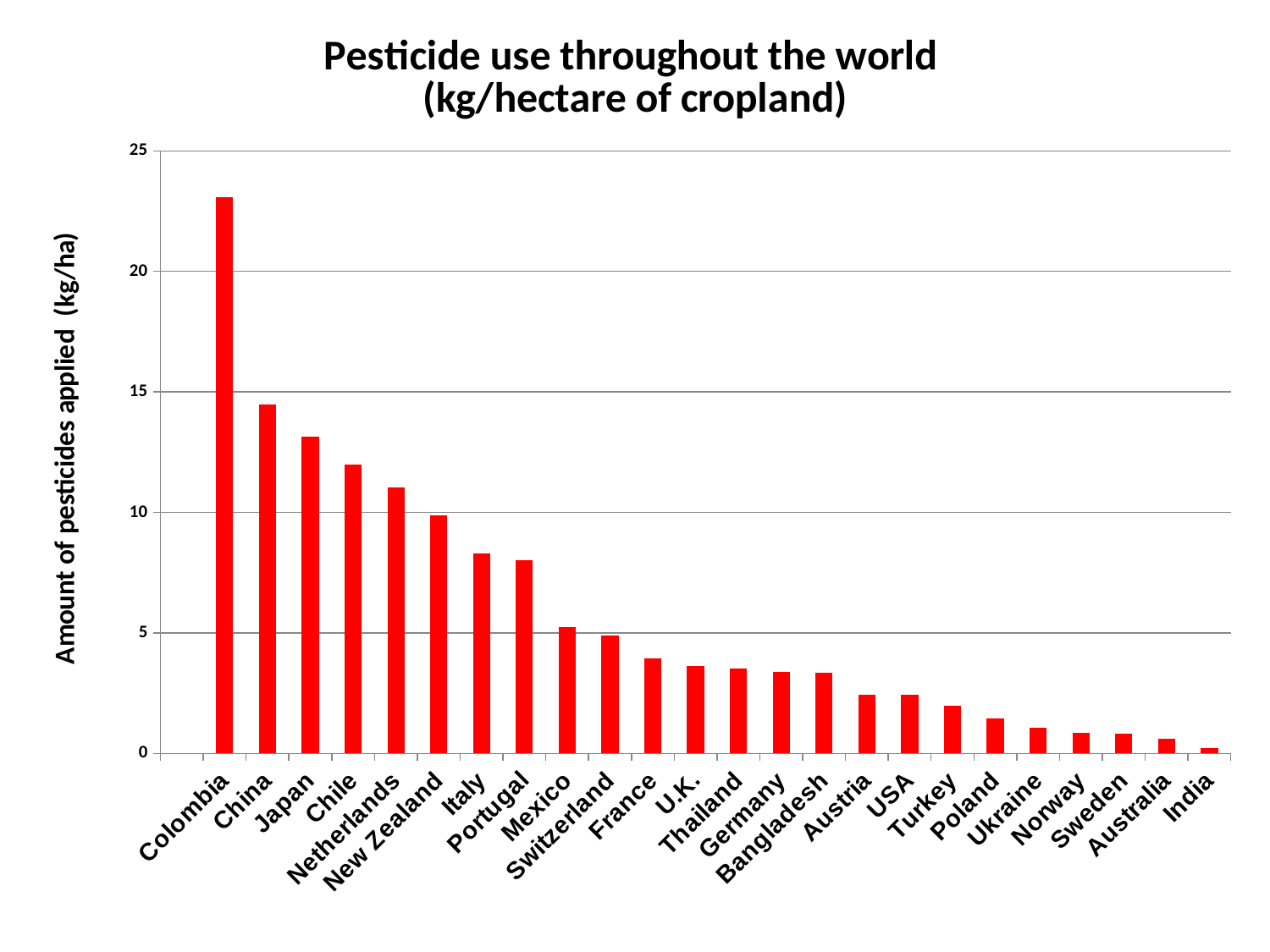
Do the values rise or fall moving from left to right along the x axis? fall Is the value for Colombia greater or less than 20? greater How many countries are shown on the chart? 24 What is the title of the chart? Pesticide use throughout the world (kg/hectare of cropland) Which has a higher value, Colombia or China? Colombia Is the value for Italy greater or less than 10? less Which has a higher value, Japan or Chile? Japan Which country has the lowest pesticide use per hectare of cropland? India Which country has the highest pesticide use per hectare of cropland? Colombia Is the value for France greater or less than 5? less What kind of chart is shown on the slide? bar chart